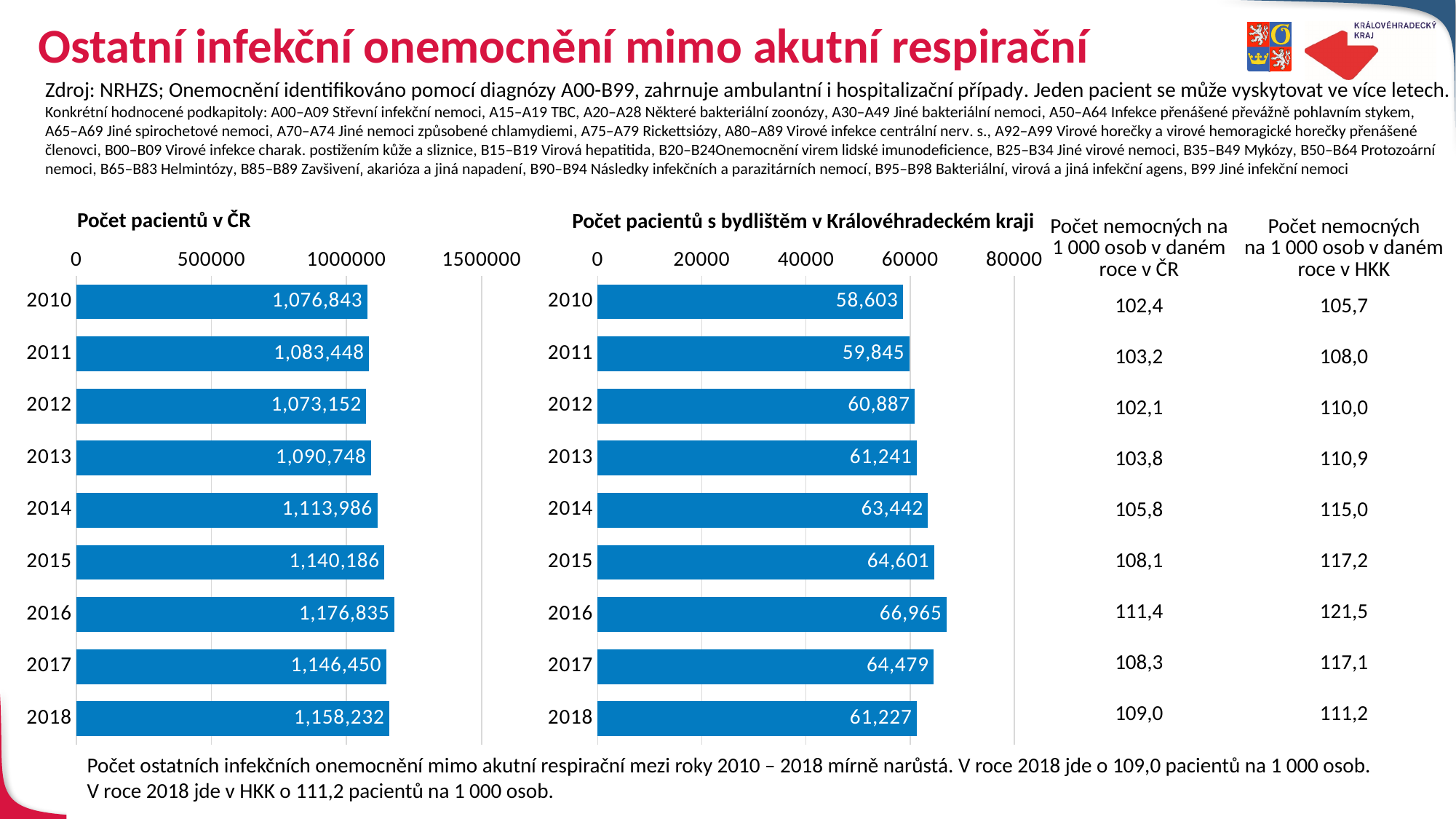
In the chart 'Počet pacientů v ČR', what is the value for 2016? 1,176,835 How many years are shown in the chart 'Počet pacientů s bydlištěm v Královéhradeckém kraji'? 9 In the chart 'Počet pacientů v ČR', what is the difference between the values for 2018 and 2010? 81,389 In the chart 'Počet pacientů s bydlištěm v Královéhradeckém kraji', which is larger, the value for 2017 or the value for 2018? 2017 In the chart 'Počet pacientů s bydlištěm v Královéhradeckém kraji', do the values rise or fall from 2010 to 2016? rise In the chart 'Počet pacientů v ČR', which year has the lowest value? 2012 In the chart 'Počet pacientů s bydlištěm v Královéhradeckém kraji', what is the value for 2014? 63,442 In the chart 'Počet pacientů s bydlištěm v Královéhradeckém kraji', what is the difference between the values for 2016 and 2010? 8,362 What kind of chart is 'Počet pacientů v ČR'? bar chart In the chart 'Počet pacientů v ČR', which year has the highest value? 2016 In the chart 'Počet pacientů s bydlištěm v Královéhradeckém kraji', which year has the lowest value? 2010 In the chart 'Počet pacientů v ČR', is the value for 2015 greater or less than 1000000? greater